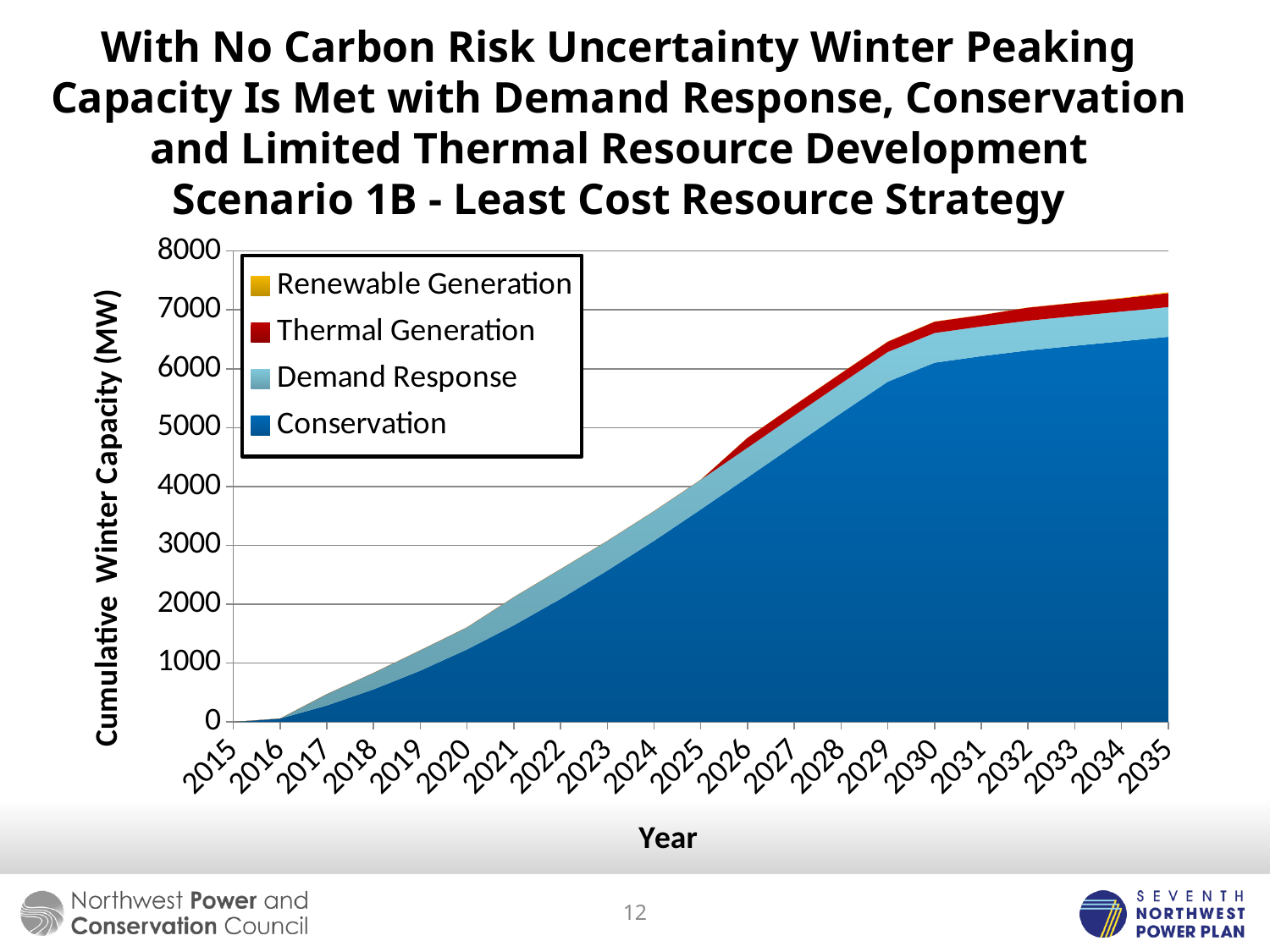
Is the total cumulative winter capacity in 2030 greater or less than 6000? greater Is the Conservation value in 2035 greater or less than 6000? greater What is the label of the y axis? Cumulative Winter Capacity (MW) Does the total cumulative winter capacity rise or fall from 2015 to 2035? Rises In 2035, which is larger: the Conservation contribution or the Demand Response contribution? Conservation Which series contributes the largest share of cumulative winter capacity in 2035? Conservation How many years are shown along the x axis? 21 Is the total cumulative winter capacity in 2035 greater or less than 7000? greater What kind of chart is shown on the slide? Stacked area chart Which series is shown in red? Thermal Generation How many series does the legend list? 4